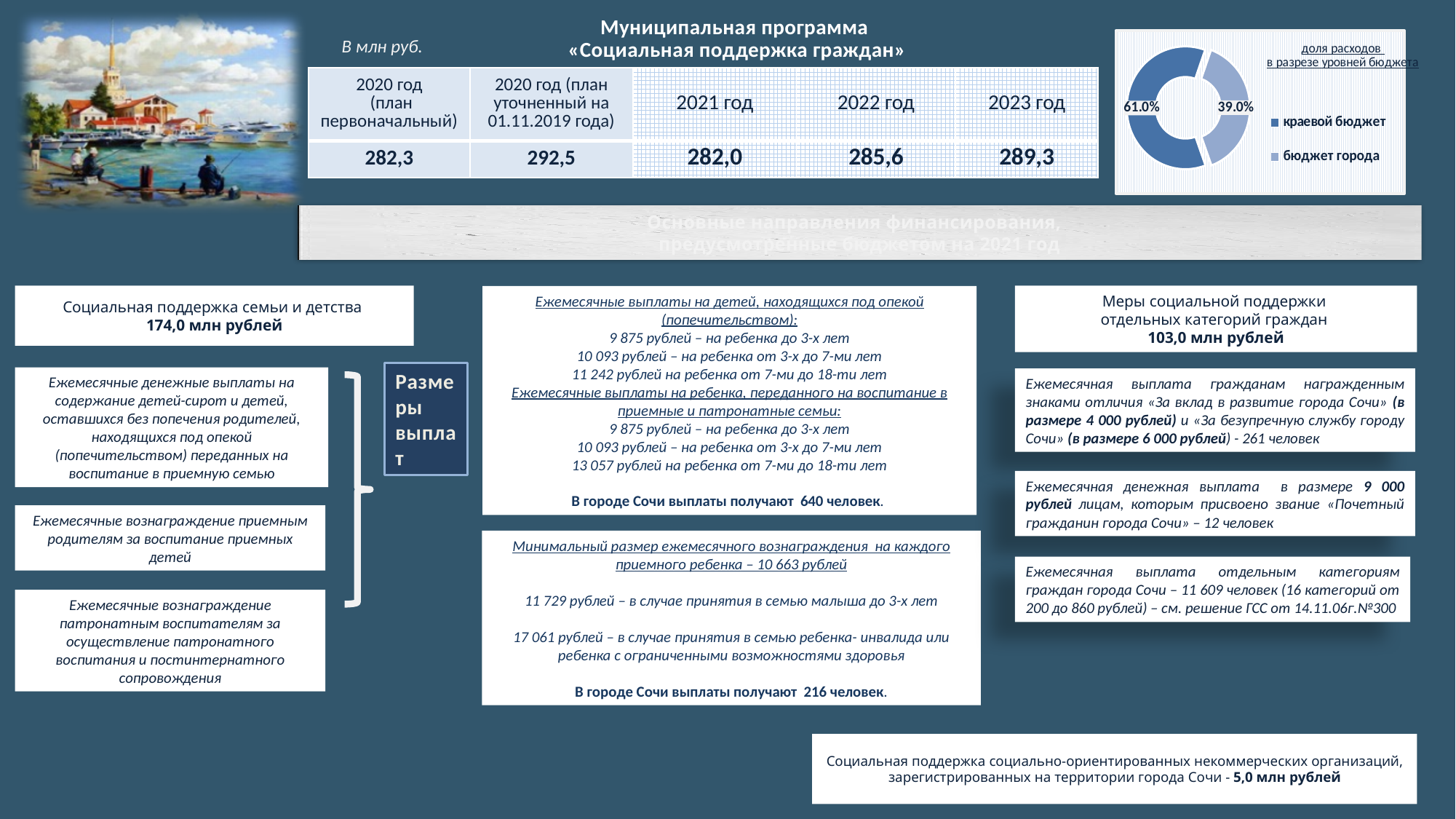
What share of expenditures does the doughnut chart show for «краевой бюджет»? 61.0% What type of chart is used to show the share of expenditures by budget level? Doughnut chart How many slices does the doughnut chart have? 2 Which budget level has the largest share in the doughnut chart? краевой бюджет How many entries does the legend of the doughnut chart list? 2 In the doughnut chart, which is larger: the share of «краевой бюджет» or the share of «бюджет города»? краевой бюджет What is the title of the doughnut chart? доля расходов в разрезе уровней бюджета By how many percentage points does the share of «краевой бюджет» exceed the share of «бюджет города» in the doughnut chart? 22.0% What share of expenditures does the doughnut chart show for «бюджет города»? 39.0% Which budget level has the smallest share in the doughnut chart? бюджет города Is the share of «краевой бюджет» in the doughnut chart greater or less than 50%? greater Which legend entry of the doughnut chart is shown in the lighter blue colour? бюджет города